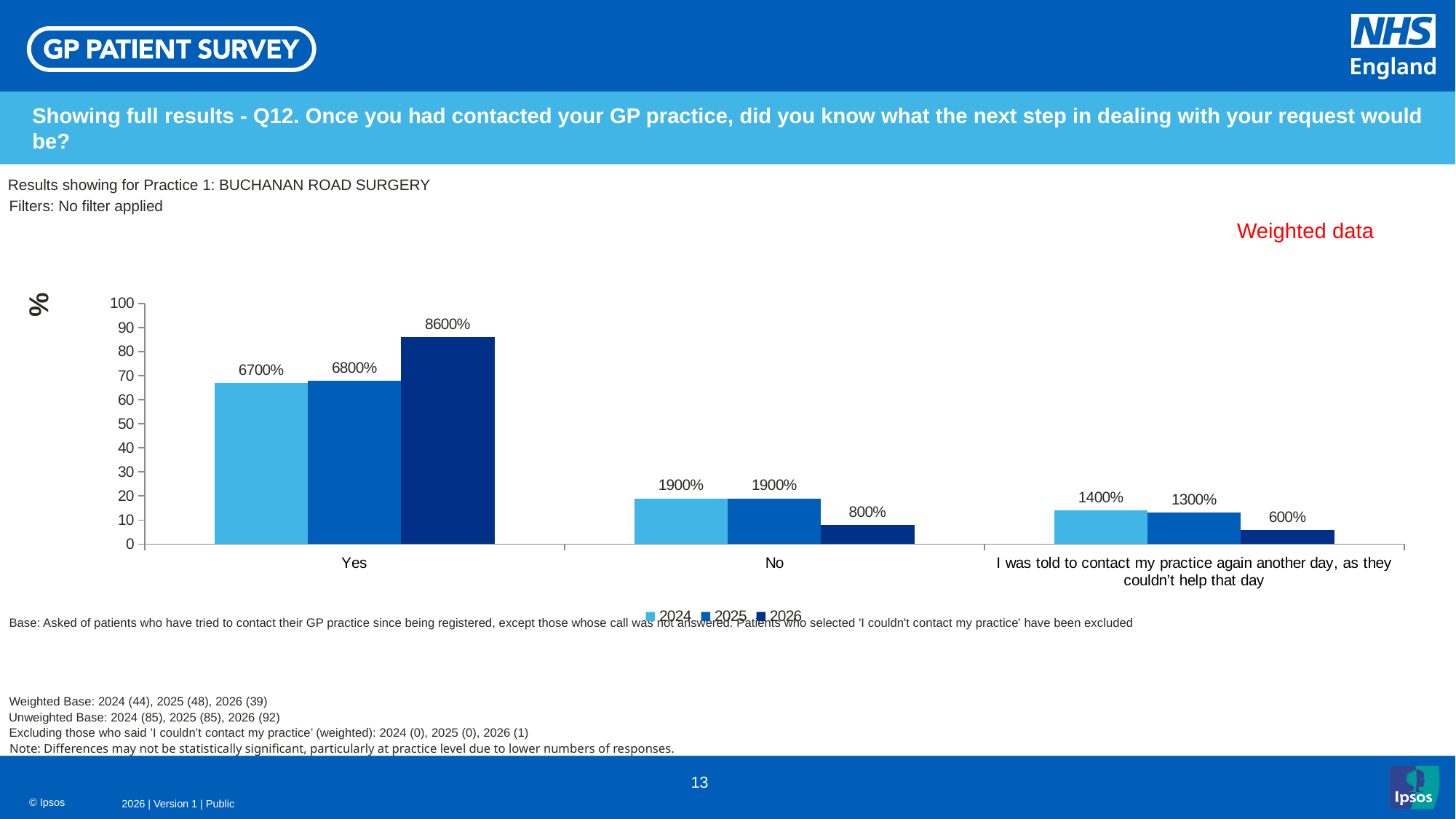
What kind of chart is shown on the slide? Bar chart In the 'Yes' category, which is larger: the 2024 bar or the 2025 bar? 2025 Is the 2026 bar in the 'Yes' category greater or less than 80 on the axis? greater Which year has the lowest bar in the 'I was told to contact my practice again another day, as they couldn't help that day' category? 2026 What is the data label for 2026 in the 'Yes' category? 8600% How many series does the legend list? 3 What is the data label for 2026 in the 'No' category? 800% What is the data label for 2025 in the 'I was told to contact my practice again another day, as they couldn't help that day' category? 1300% Which year has the highest bar in the 'Yes' category? 2026 Do the bars for the 'Yes' category rise or fall from 2024 to 2026? Rise How many categories are shown on the x axis? 3 What is the data label for 2024 in the 'No' category? 1900%